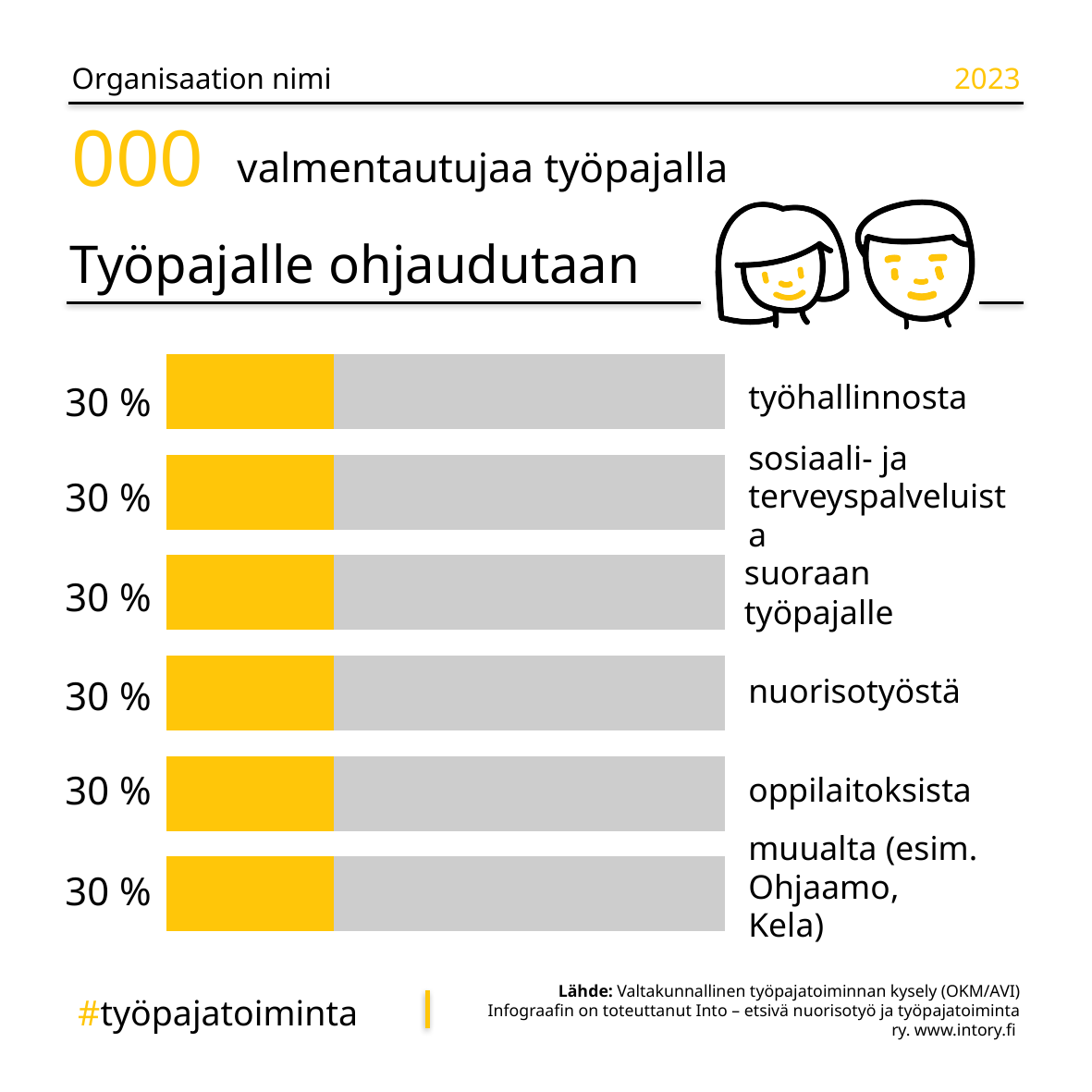
How many categories are shown in the chart? 6 What kind of chart is shown on the slide? bar chart What is the difference between the values for työhallinnosta and oppilaitoksista? 0 % Do the values change from the top bar to the bottom bar? No, all are 30 % What colour is the filled portion of each bar? yellow What is the value shown for oppilaitoksista? 30 % What is the title of the chart? Työpajalle ohjaudutaan What is the value shown for sosiaali- ja terveyspalveluista? 30 % What is the value shown for suoraan työpajalle? 30 % What is the value shown for muualta (esim. Ohjaamo, Kela)? 30 % What is the value shown for työhallinnosta? 30 % What is the value shown for nuorisotyöstä? 30 %